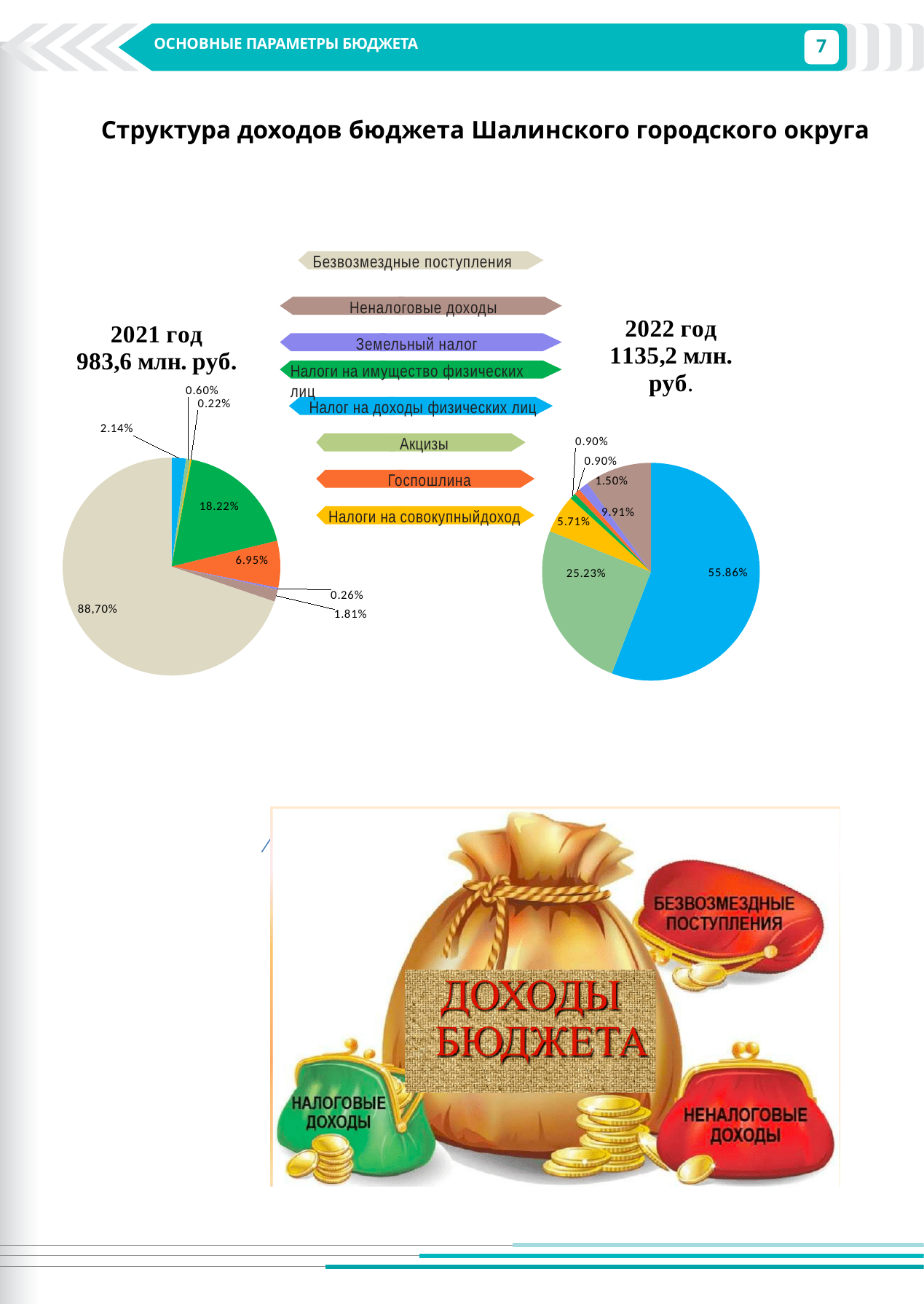
What total revenue is stated above the 2022 год pie chart? 1135,2 млн. руб. In the 2022 год pie chart, what share is shown for the light-green slice (Акцизы)? 25.23% What kind of charts are shown on the slide for 2021 and 2022? Pie charts In the 2022 год pie chart, what share is shown for the brownish slice (Неналоговые доходы)? 9.91% What total revenue is stated above the 2021 год pie chart? 983,6 млн. руб. In the 2022 год pie chart, what is the share of the largest slice? 55.86% In the 2021 год pie chart, which is larger: the green slice at 18.22% or the orange slice at 6.95%? The green slice (18.22%) In the 2021 год pie chart, what is the share of the largest slice? 88,70% In the 2021 год pie chart, what is the share of the smallest labelled slice? 0.22% In the 2022 год pie chart, what is the difference between the 55.86% slice and the 25.23% slice? 30.63% How many slices are labelled in the 2022 год pie chart? 7 How many categories does the legend between the two pie charts list? 8